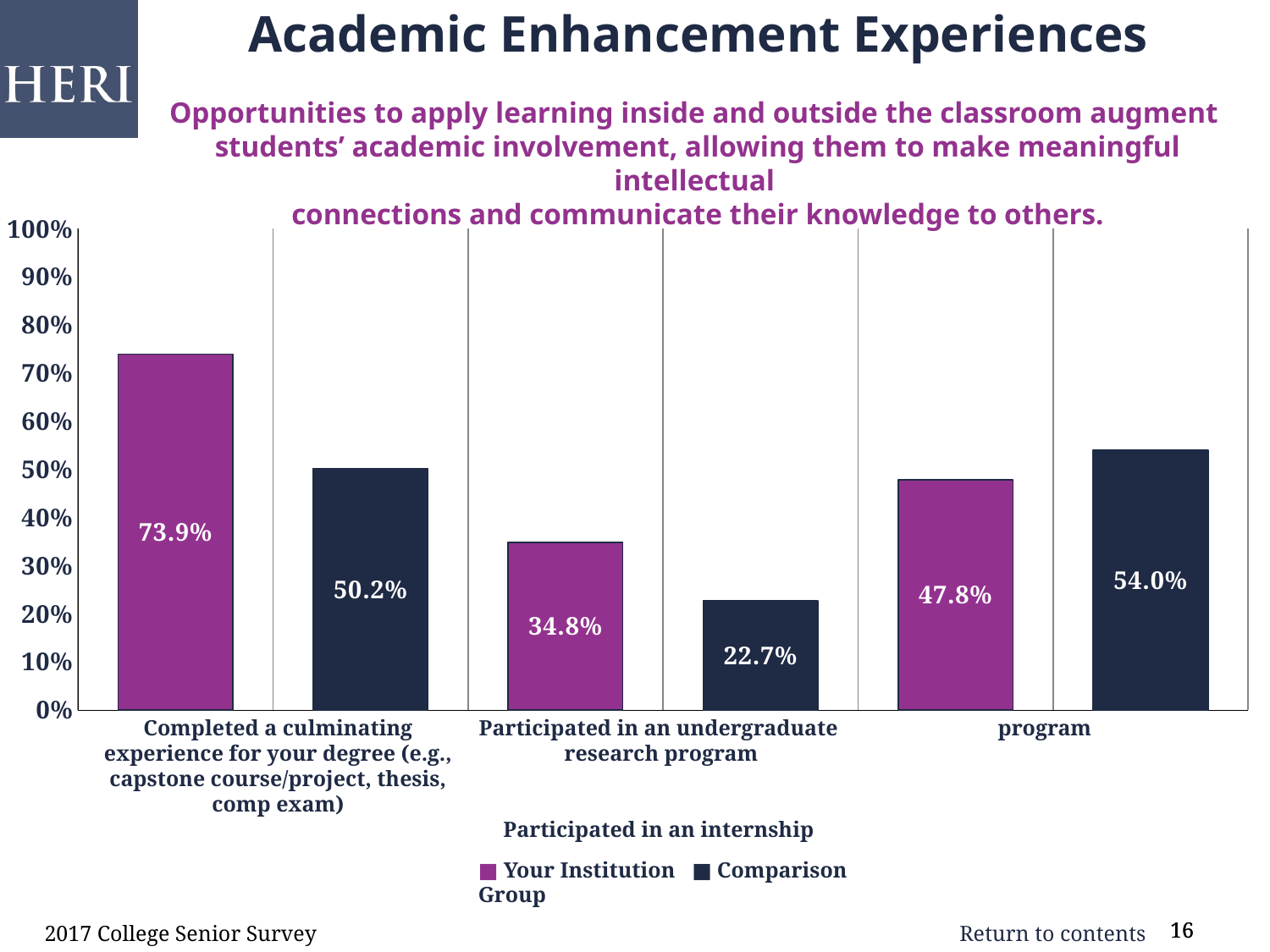
How many categories are shown on the x axis of the chart? 3 Which category has the lowest value for the Comparison Group? Participated in an undergraduate research program How many series does the legend list? 2 What is the Your Institution value for participating in an internship program? 47.8% What is the Comparison Group value for participating in an internship program? 54.0% Which category has the highest value for Your Institution? Completed a culminating experience for your degree What is the difference between Your Institution and the Comparison Group for completing a culminating experience? 23.7% What percentage of Your Institution students completed a culminating experience for their degree? 73.9% What is the Comparison Group value for participating in an undergraduate research program? 22.7% What type of chart is shown on the slide? Bar chart For participating in an internship program, which is larger: Your Institution or the Comparison Group? Comparison Group Is the Your Institution value for participating in an undergraduate research program greater or less than 40%? less